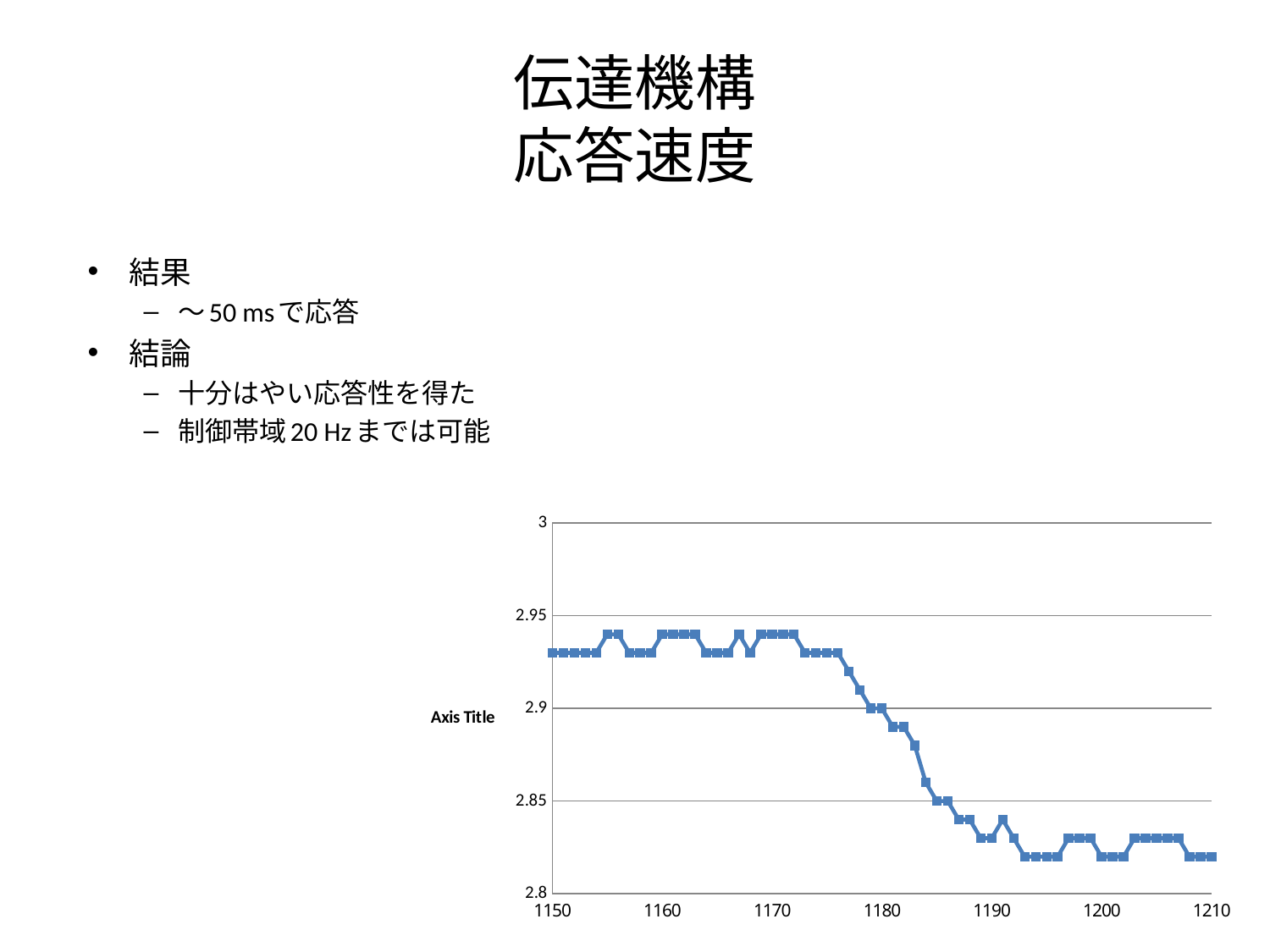
Do the plotted values generally rise or fall as the x axis goes from 1150 to 1210? fall Is the value at x = 1160 greater or less than 2.95? less Is the value at x = 1150 greater or less than 2.9? greater What are the minimum and maximum values shown on the vertical axis of the chart? 2.8 and 3 What is the label shown on the vertical axis of the chart? Axis Title Which is larger, the value at x = 1150 or the value at x = 1210? the value at x = 1150 Is the value at x = 1170 greater or less than 2.9? greater What kind of chart is shown on the slide? line chart Which is larger, the value at x = 1190 or the value at x = 1170? the value at x = 1170